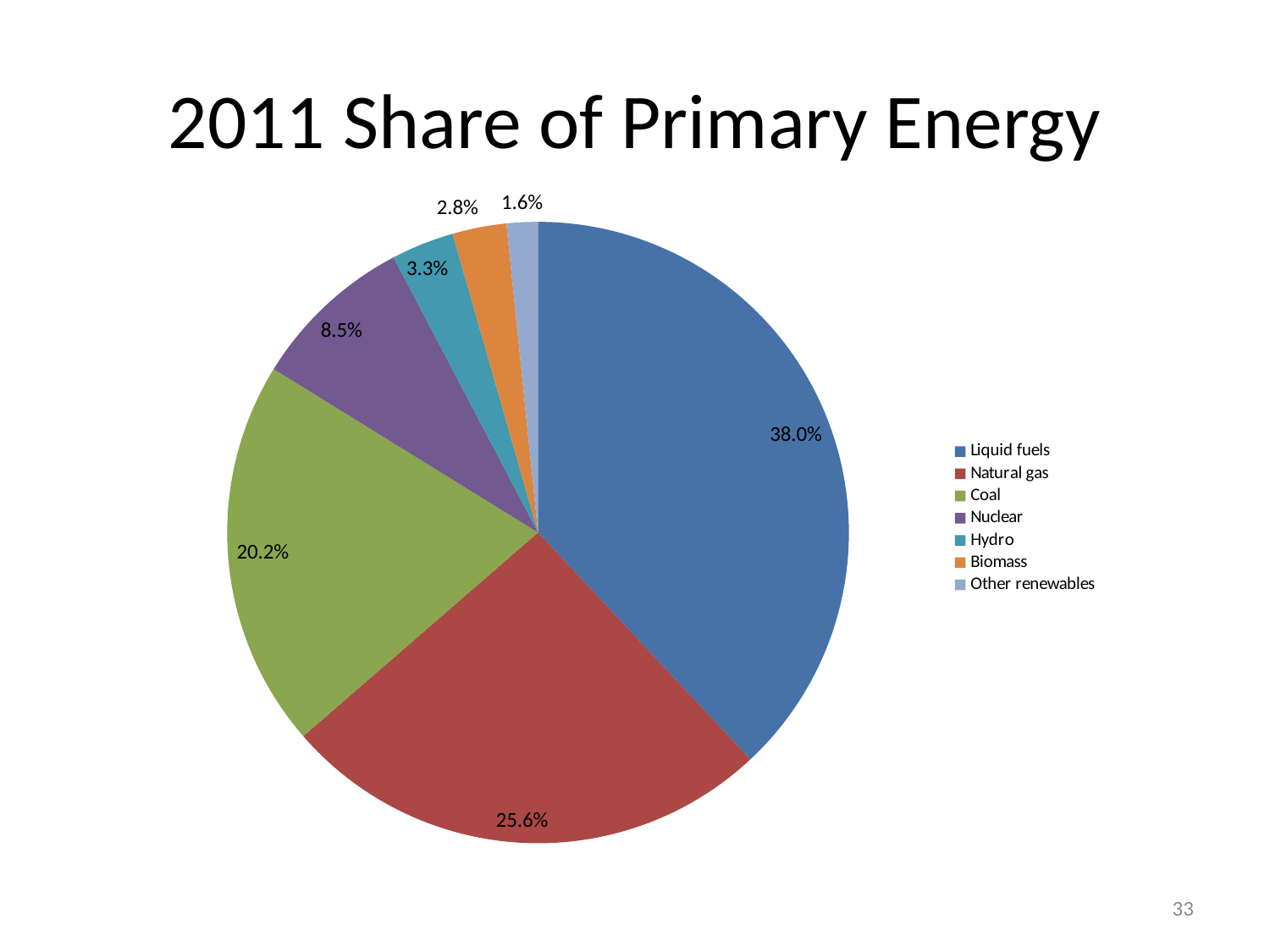
Which energy source has the largest share of primary energy? Liquid fuels What share of primary energy does Other renewables have? 1.6% What share of primary energy does Natural gas have? 25.6% What type of chart is shown on the slide? Pie chart What is the difference in share between Liquid fuels and Natural gas? 12.4% Which energy source has the smallest share of primary energy? Other renewables What share of primary energy does Hydro have? 3.3% What share of primary energy does Coal have? 20.2% What share of primary energy does Liquid fuels have? 38.0% What share of primary energy does Nuclear have? 8.5% How many energy sources are shown in the pie chart? 7 Which has a larger share, Coal or Nuclear? Coal